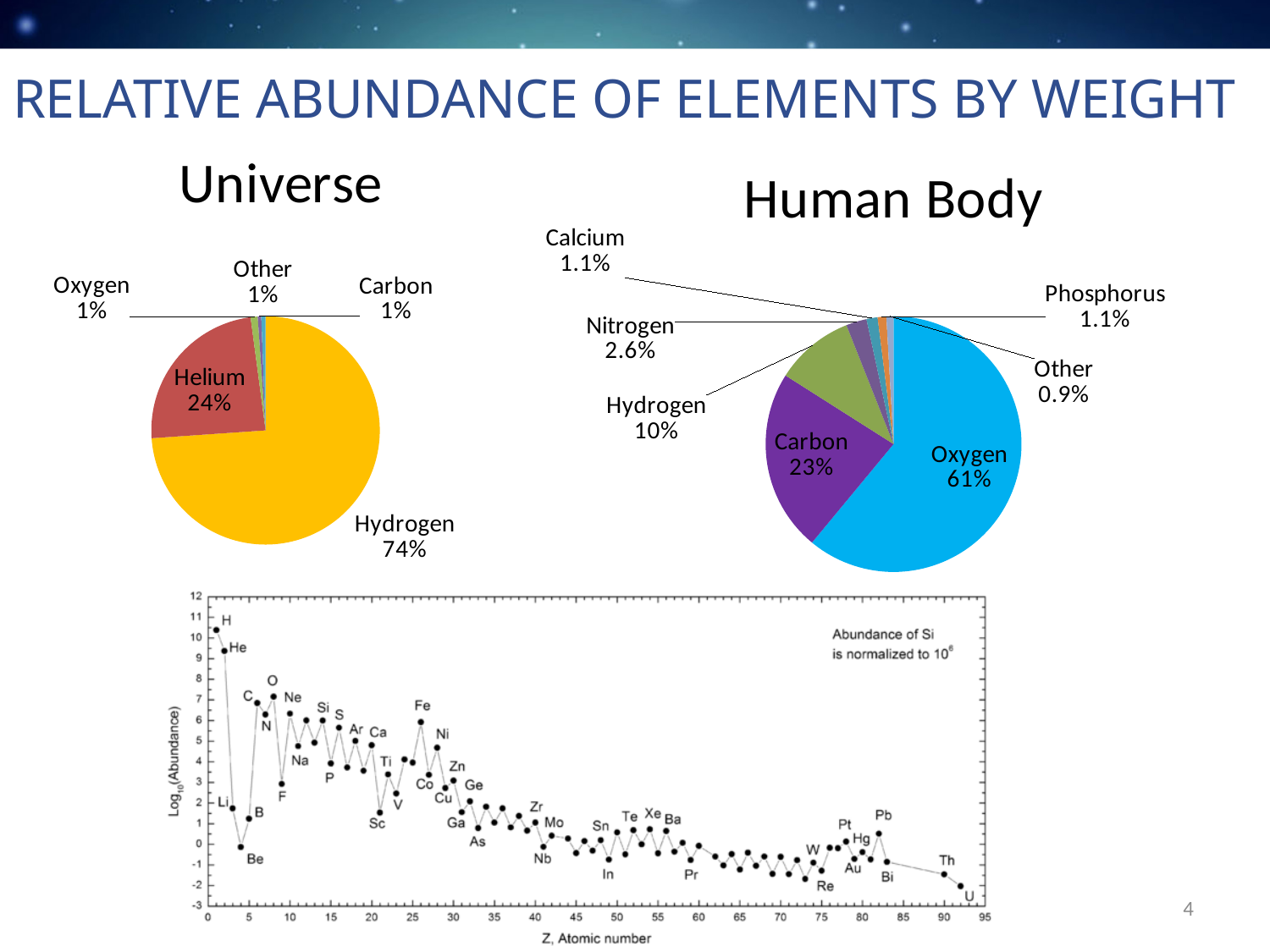
In the Human Body pie chart, which slice is the smallest? Other In the Universe pie chart, what is the difference between the Hydrogen and Helium shares? 50% How many slices does the Human Body pie chart have? 7 In the Universe pie chart, what is the share for Hydrogen? 74% In the Human Body pie chart, which is larger, Carbon or Hydrogen? Carbon In the Human Body pie chart, what is the share for Nitrogen? 2.6% In the bottom chart, is the Log10(Abundance) value for Be greater or less than 0? less In the bottom chart, is the Log10(Abundance) value for Fe greater or less than 5? greater What is the label of the x axis of the bottom chart? Z, Atomic number In the Universe pie chart, which element has the largest slice? Hydrogen In the Human Body pie chart, what is the share for Oxygen? 61% In the Universe pie chart, what is the share for Helium? 24%